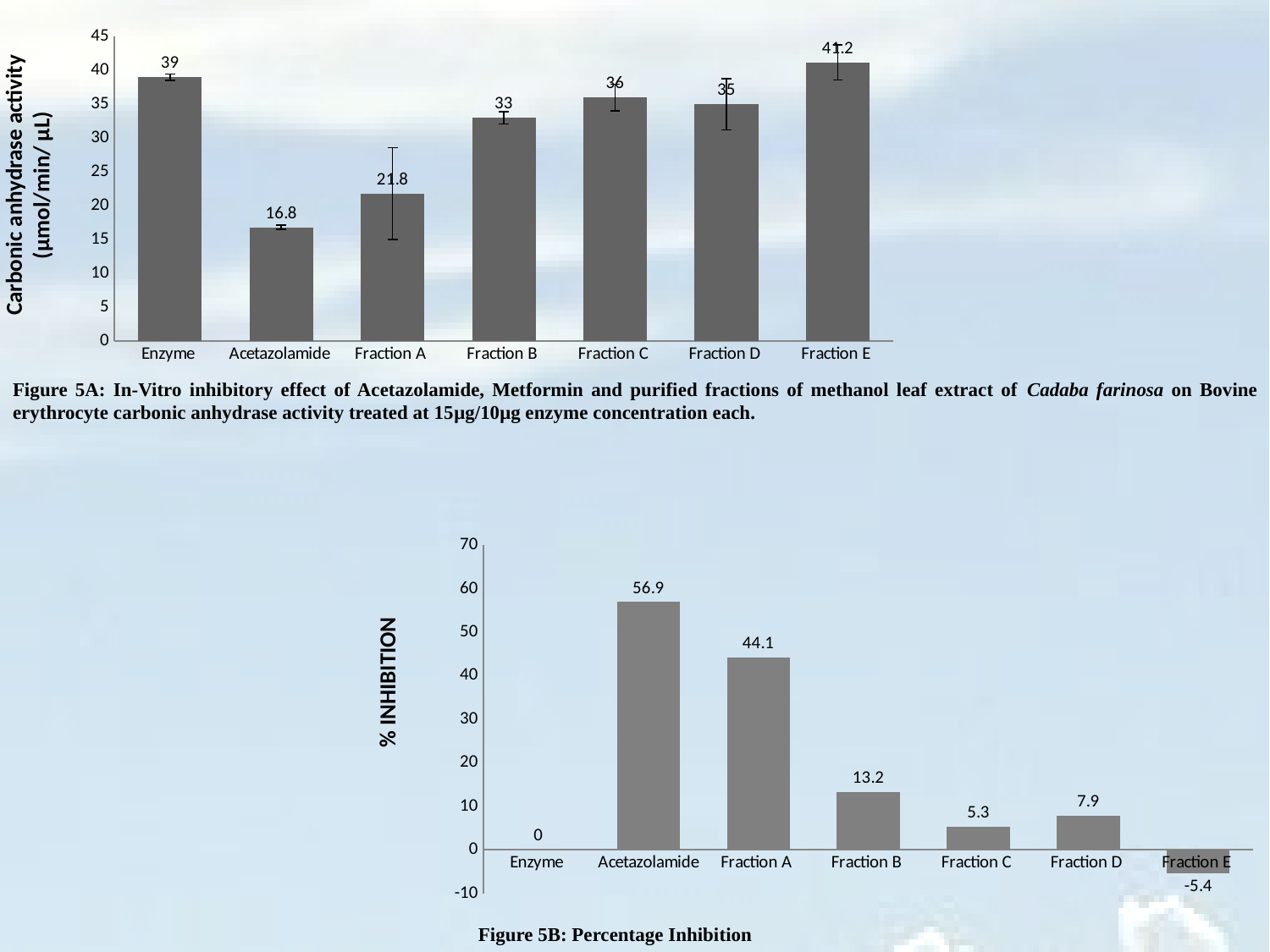
In the bottom chart (Figure 5B), what is the % inhibition for Fraction E? -5.4 In the top chart (Figure 5A), what is the carbonic anhydrase activity for Acetazolamide? 16.8 In the bottom chart (Figure 5B), what is the difference between the Acetazolamide value and the Fraction A value? 12.8 In the top chart (Figure 5A), what is the value for Fraction E? 41.2 In the bottom chart (Figure 5B), which is larger, the value for Fraction B or the value for Fraction D? Fraction B In the top chart (Figure 5A), which category has the highest value? Fraction E What kind of chart is Figure 5B? Bar chart In the top chart (Figure 5A), how many categories are shown on the x axis? 7 In the bottom chart (Figure 5B), what is the % inhibition for Fraction A? 44.1 In the top chart (Figure 5A), what is the difference between the Enzyme value and the Fraction A value? 17.2 In the top chart (Figure 5A), which category has the lowest carbonic anhydrase activity? Acetazolamide In the bottom chart (Figure 5B), which category has the highest % inhibition? Acetazolamide